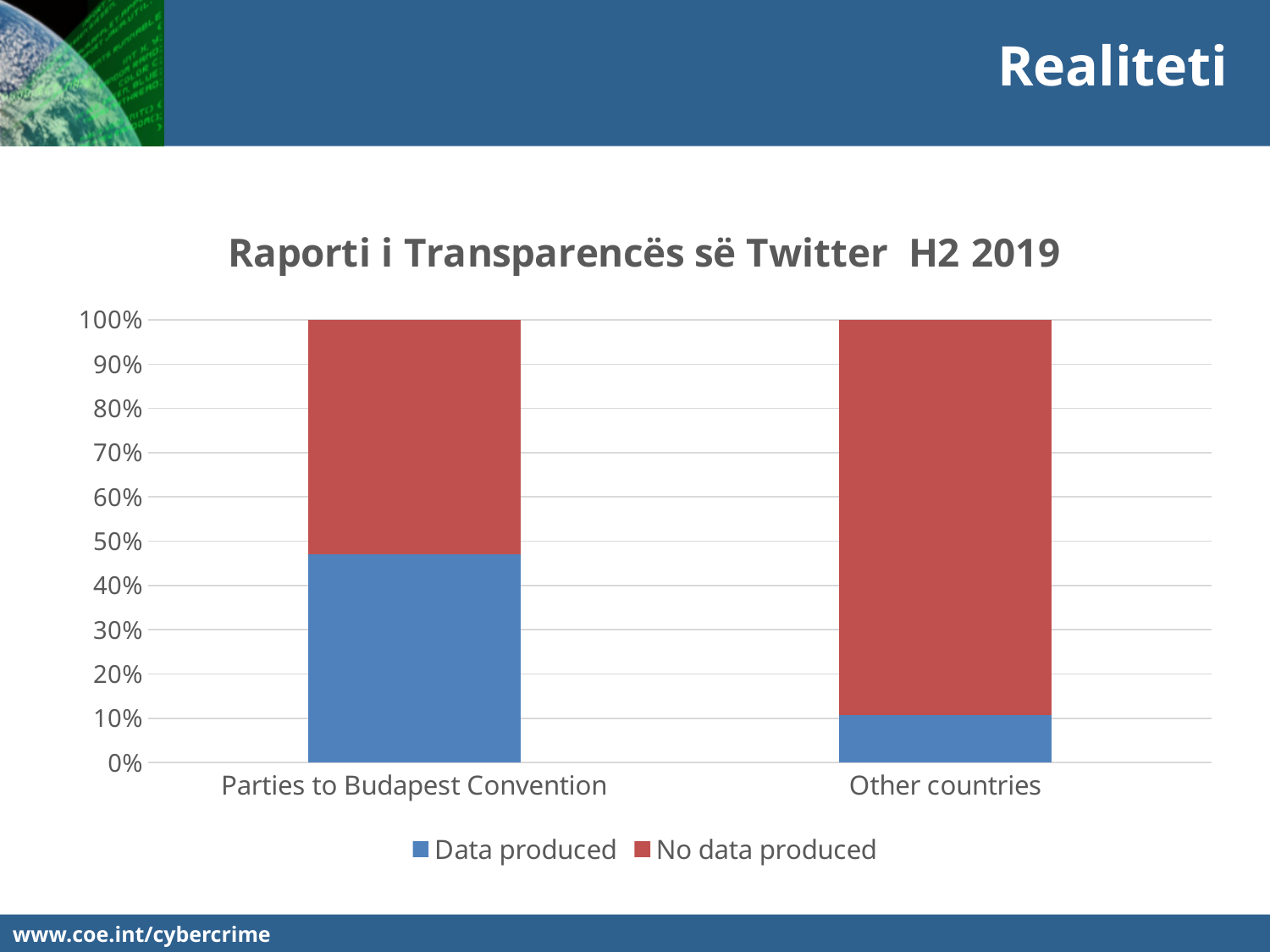
Is the 'No data produced' share for Other countries greater or less than 80%? greater What is the title of the chart? Raporti i Transparencës së Twitter H2 2019 Which category has the larger 'Data produced' share, Parties to Budapest Convention or Other countries? Parties to Budapest Convention Is the 'Data produced' value for Parties to Budapest Convention greater or less than 40%? greater Is the 'Data produced' value for Other countries greater or less than 20%? less What kind of chart is shown on the slide? stacked bar chart Which category has the highest 'No data produced' share? Other countries What is the total height of the stacked bar for Other countries? 100% How many series does the legend list? 2 Which series is shown in blue? Data produced How many categories are shown on the x axis? 2